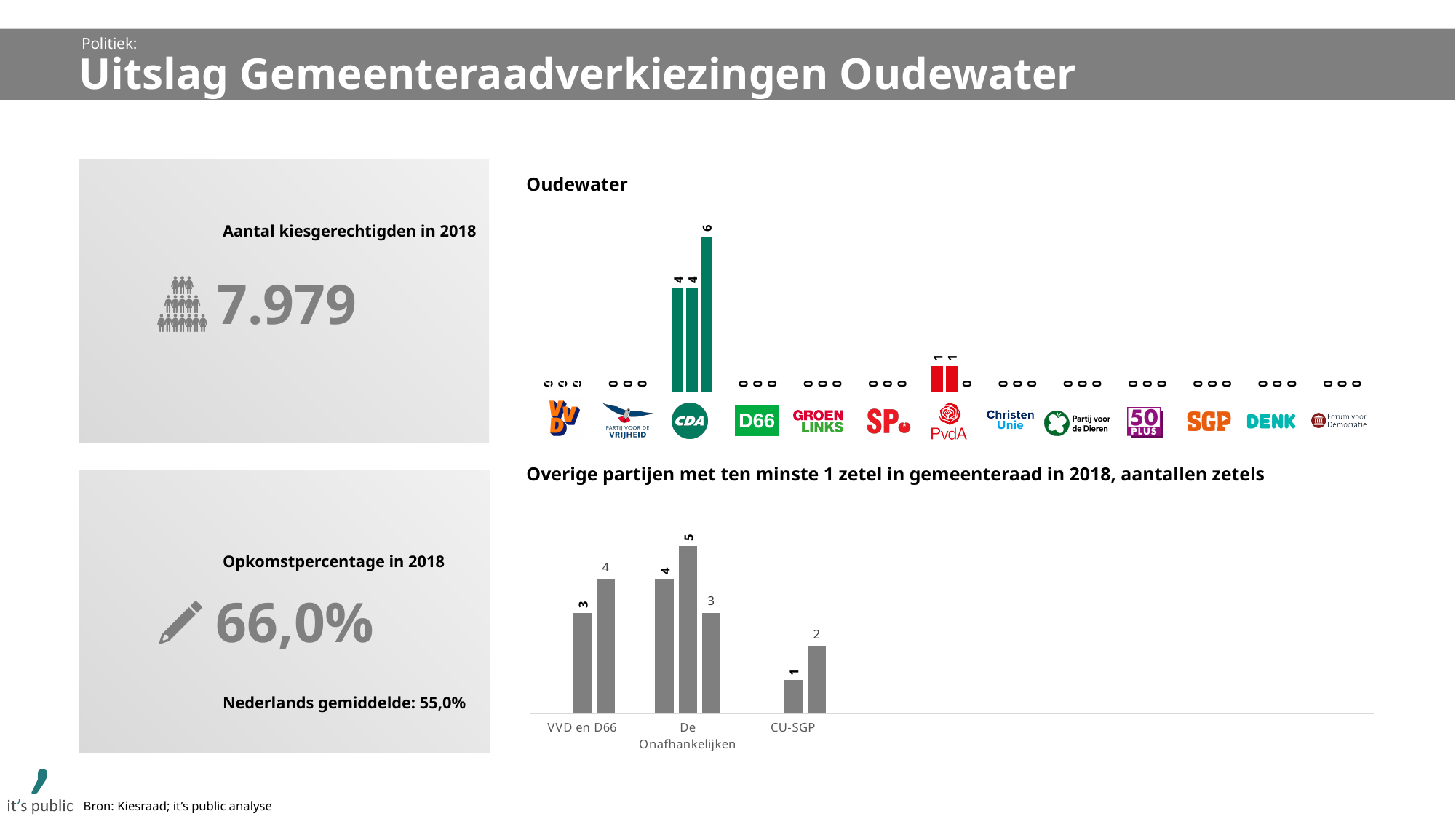
In the bottom chart 'Overige partijen met ten minste 1 zetel in gemeenteraad in 2018', how many bars are shown for De Onafhankelijken? 3 In the bottom chart 'Overige partijen met ten minste 1 zetel in gemeenteraad in 2018', what is the difference between the tallest bar for De Onafhankelijken and the tallest bar for CU-SGP? 3 In the top chart 'Oudewater', which party has the tallest bar? CDA In the bottom chart 'Overige partijen met ten minste 1 zetel in gemeenteraad in 2018', how many categories are shown on the x axis? 3 In the bottom chart 'Overige partijen met ten minste 1 zetel in gemeenteraad in 2018', what is the value of the tallest bar for De Onafhankelijken? 5 In the bottom chart 'Overige partijen met ten minste 1 zetel in gemeenteraad in 2018', which category has the tallest bar? De Onafhankelijken In the top chart 'Oudewater', what are the three values shown for PvdA, from left to right? 1, 1, 0 In the bottom chart 'Overige partijen met ten minste 1 zetel in gemeenteraad in 2018', what are the values of the two bars for VVD en D66, from left to right? 3 and 4 In the bottom chart 'Overige partijen met ten minste 1 zetel in gemeenteraad in 2018', what is the value of the lowest bar? 1 In the top chart 'Oudewater', what is the highest value shown for CDA? 6 In the top chart 'Oudewater', how many party logos are shown along the x axis? 13 What kind of chart is the bottom chart 'Overige partijen met ten minste 1 zetel in gemeenteraad in 2018'? bar chart